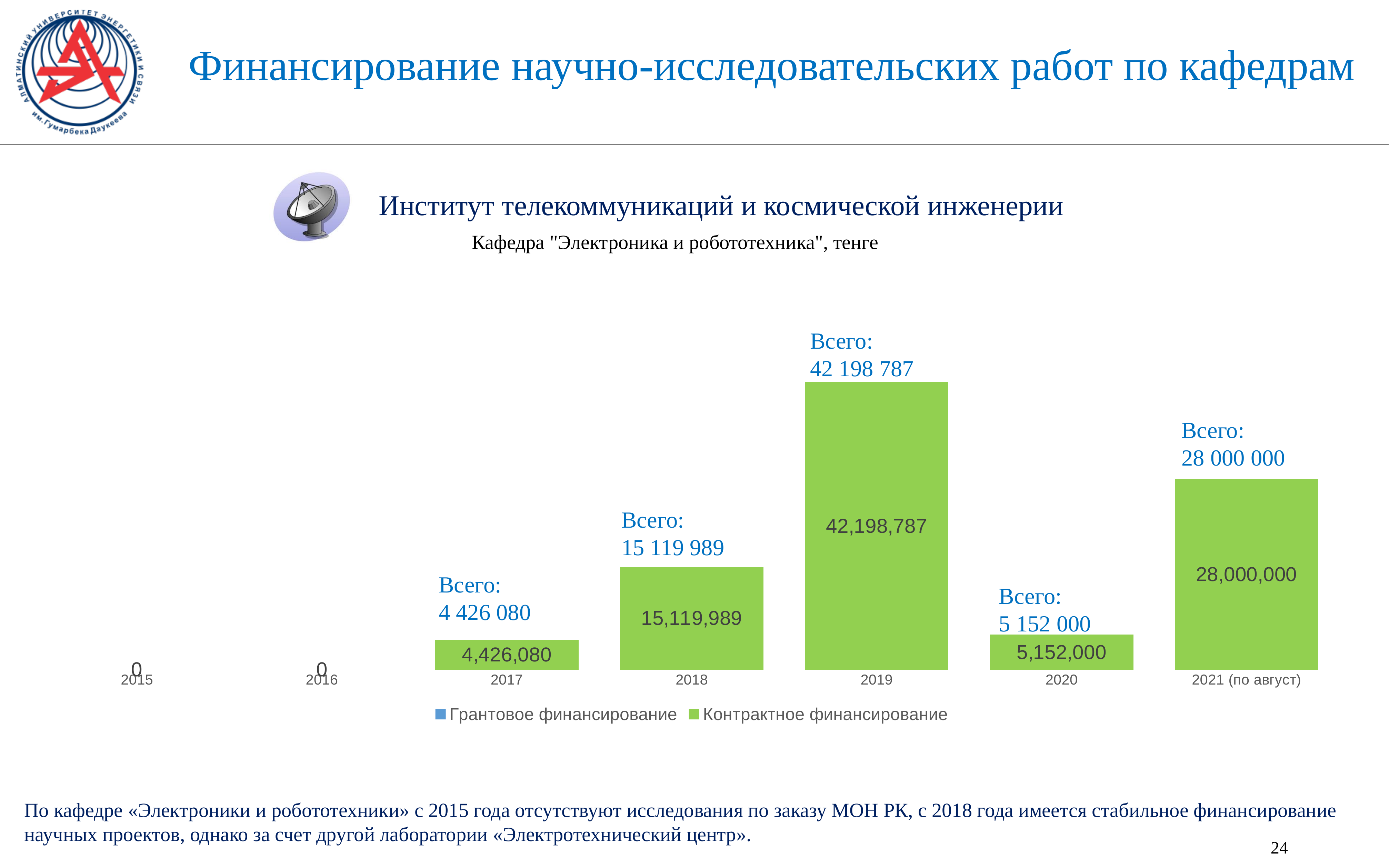
What type of chart is shown on the slide? Bar chart What is the difference between the funding values for 2018 and 2017? 10,693,909 Which is larger, the funding value for 2018 or for 2020? 2018 What is the contract funding value for 2020? 5,152,000 What is the difference between the funding values for 2019 and 2021 (по августу)? 14,198,787 What is the value shown for 2015? 0 What is the contract funding value for 2021 (по августу)? 28,000,000 How many years are shown on the x axis? 7 Which year has the highest funding value? 2019 What is the contract funding value for 2017? 4,426,080 What is the contract funding value for 2019? 42,198,787 How many series does the legend list? 2